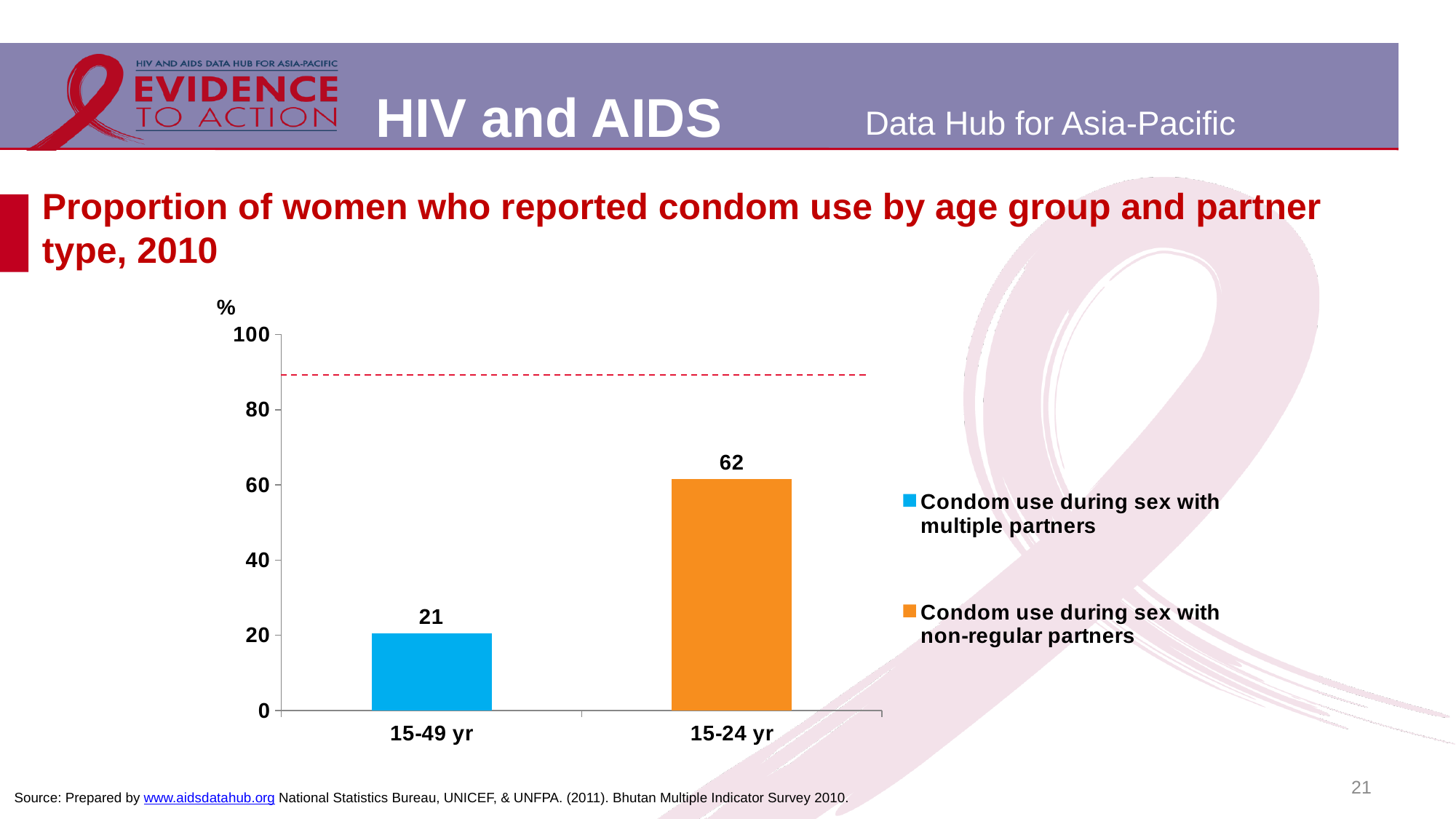
What is the value for the 15-49 yr age group? 21 What is the difference between the values for 15-24 yr and 15-49 yr? 41 What is the value for the 15-24 yr age group? 62 Is the value for 15-49 yr greater or less than 40? less What is the maximum value shown on the y axis? 100 Which age group has the lower reported condom use? 15-49 yr How many series does the legend list? 2 How many age group categories are shown on the x axis? 2 What kind of chart is shown on the slide? Bar chart Which legend entry corresponds to the orange bar? Condom use during sex with non-regular partners Is the value for 15-24 yr greater or less than 60? greater Which age group has the higher reported condom use? 15-24 yr